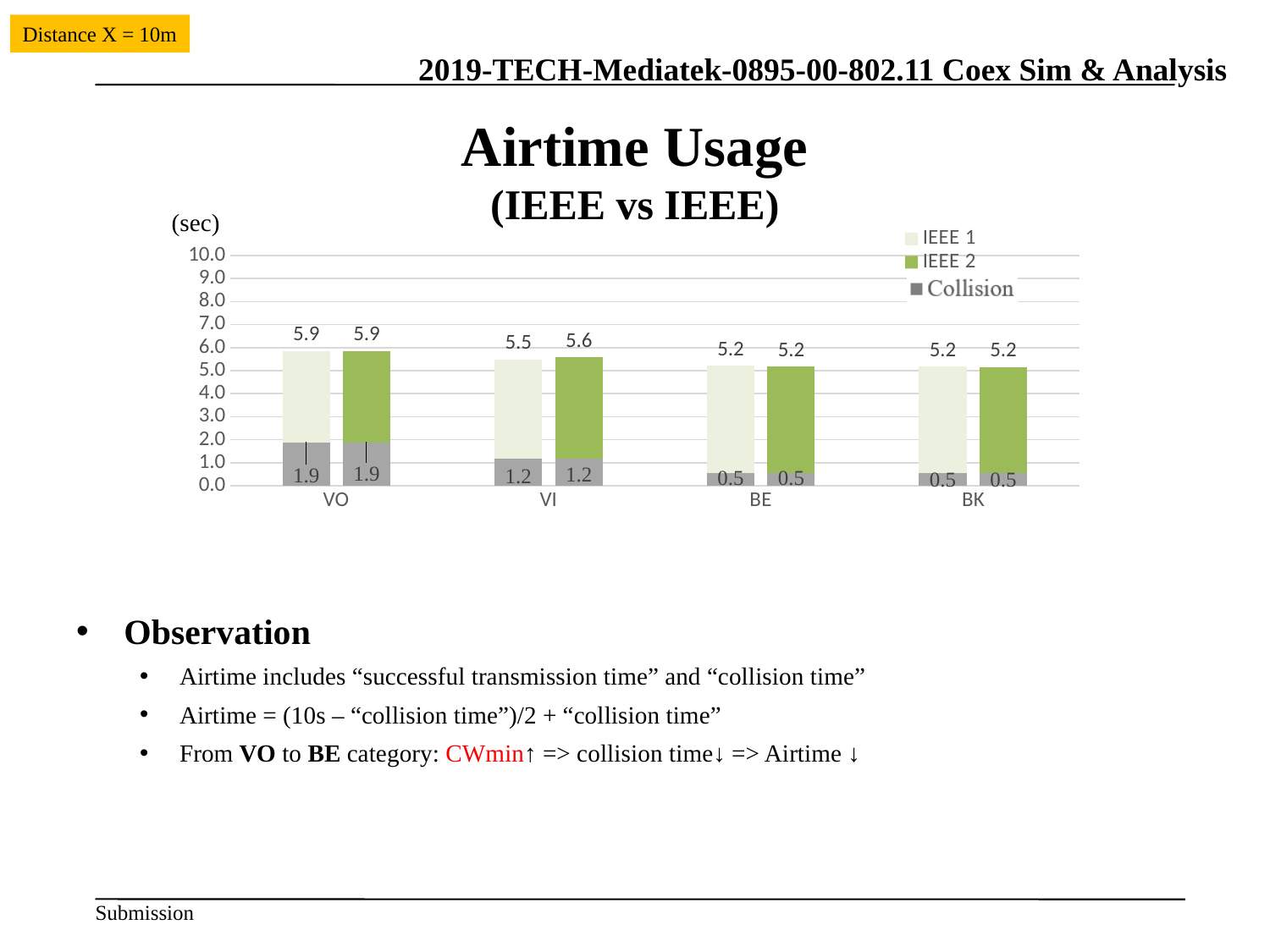
Which is larger, the IEEE 1 value for VI or the IEEE 1 value for BE? VI Which category has the highest IEEE 1 value? VO What kind of chart is shown on the slide? Bar chart Which category has the lowest collision value for IEEE 1? BE and BK (both 0.5) What is the value for IEEE 2 in the VI category? 5.6 How many series does the legend list? 3 What is the collision value shown for IEEE 1 in the BE category? 0.5 What is the value for IEEE 1 in the VO category? 5.9 What unit is shown on the y axis of the chart? sec How many categories are shown on the x axis? 4 What is the collision value shown for IEEE 2 in the VO category? 1.9 What is the difference between the IEEE 2 value for VO and the IEEE 2 value for BK? 0.7